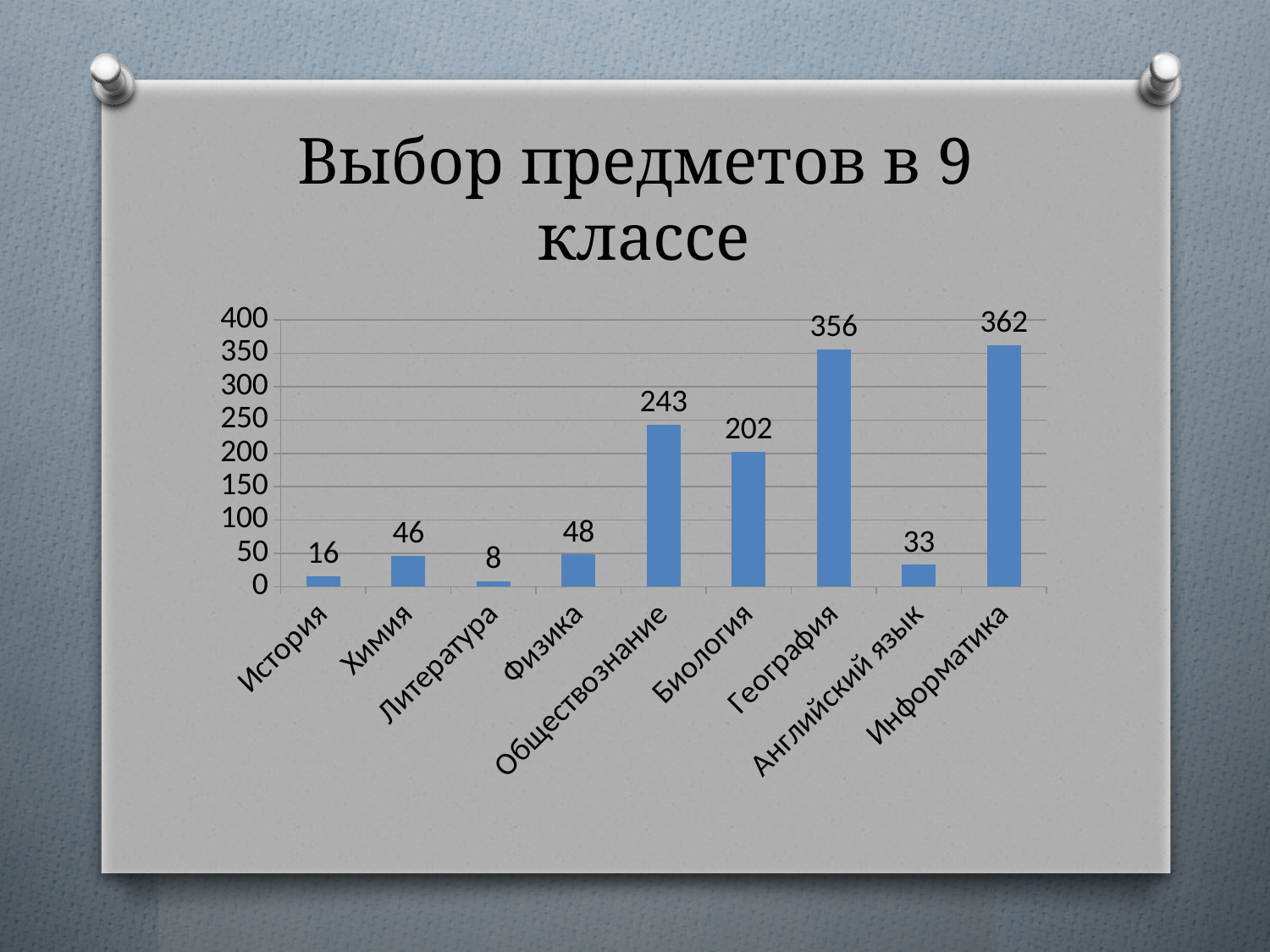
What is the difference between the values for Информатика and География? 6 How many subjects are shown on the chart? 9 Which is larger, the value for Химия or the value for Физика? Физика What is the value for Английский язык? 33 What is the title of the slide? Выбор предметов в 9 классе Is the value for Биология greater or less than 150? greater What is the difference between the values for Обществознание and Биология? 41 What is the value for Обществознание? 243 What kind of chart is shown on the slide? bar chart Which subject has the lowest value? Литература Which subject has the highest value? Информатика What is the value for История? 16